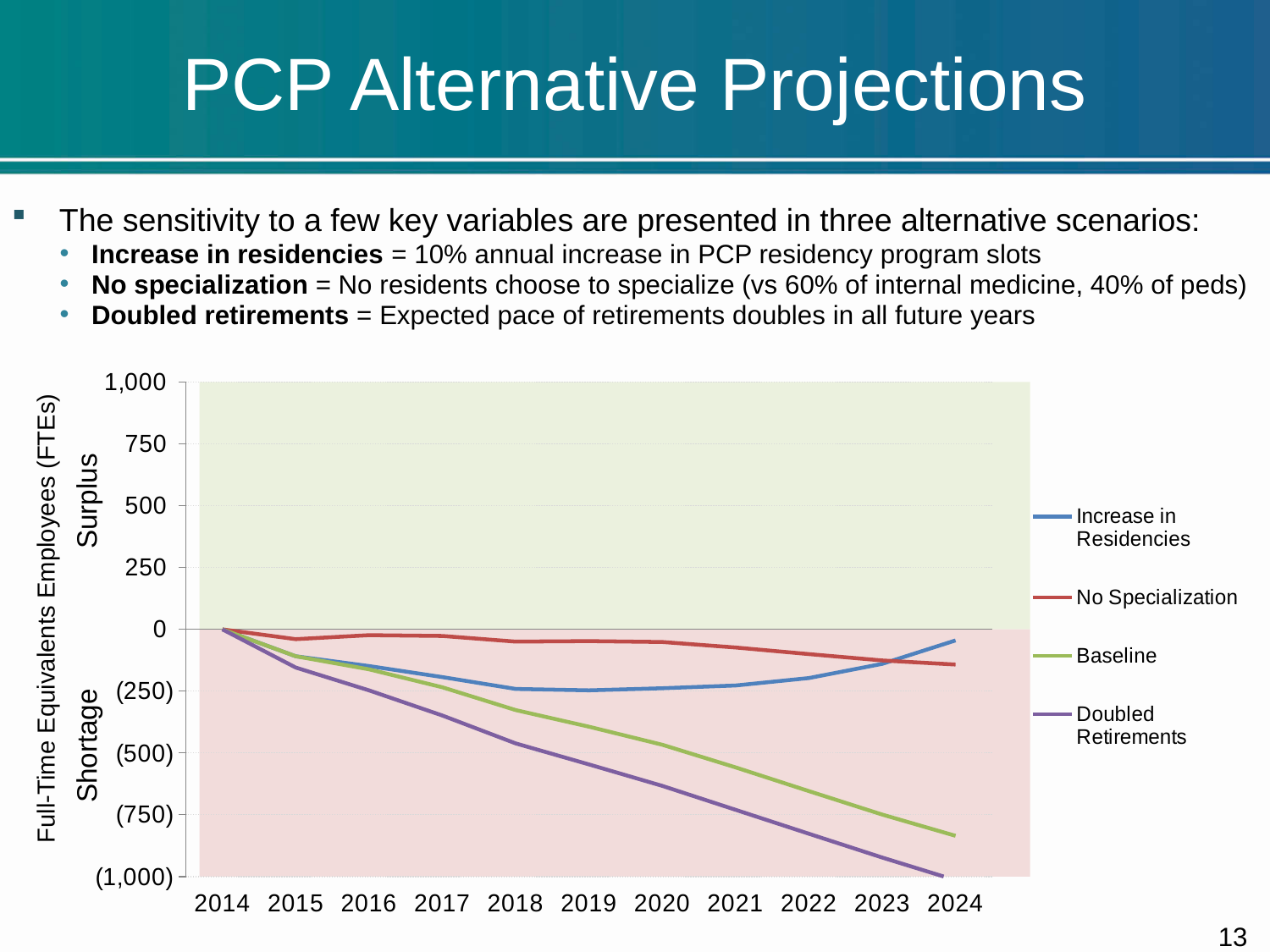
Is the No Specialization value in 2018 above or below (250)? above Which series has the highest value in 2024? Increase in Residencies What is the value of the Baseline series in 2014? 0 Is the Doubled Retirements value in 2020 above or below (500)? below What label is given to the y axis of the chart? Full-Time Equivalents Employees (FTEs) How many series does the legend list? 4 How many years are shown along the x axis? 11 What kind of chart is shown on the slide? Line chart Is the Baseline value in 2024 above or below (750)? below Which series has the lowest value in 2024? Doubled Retirements Does the Doubled Retirements series rise or fall from 2014 to 2024? Fall In 2022, which is higher: the Baseline series or the Doubled Retirements series? Baseline